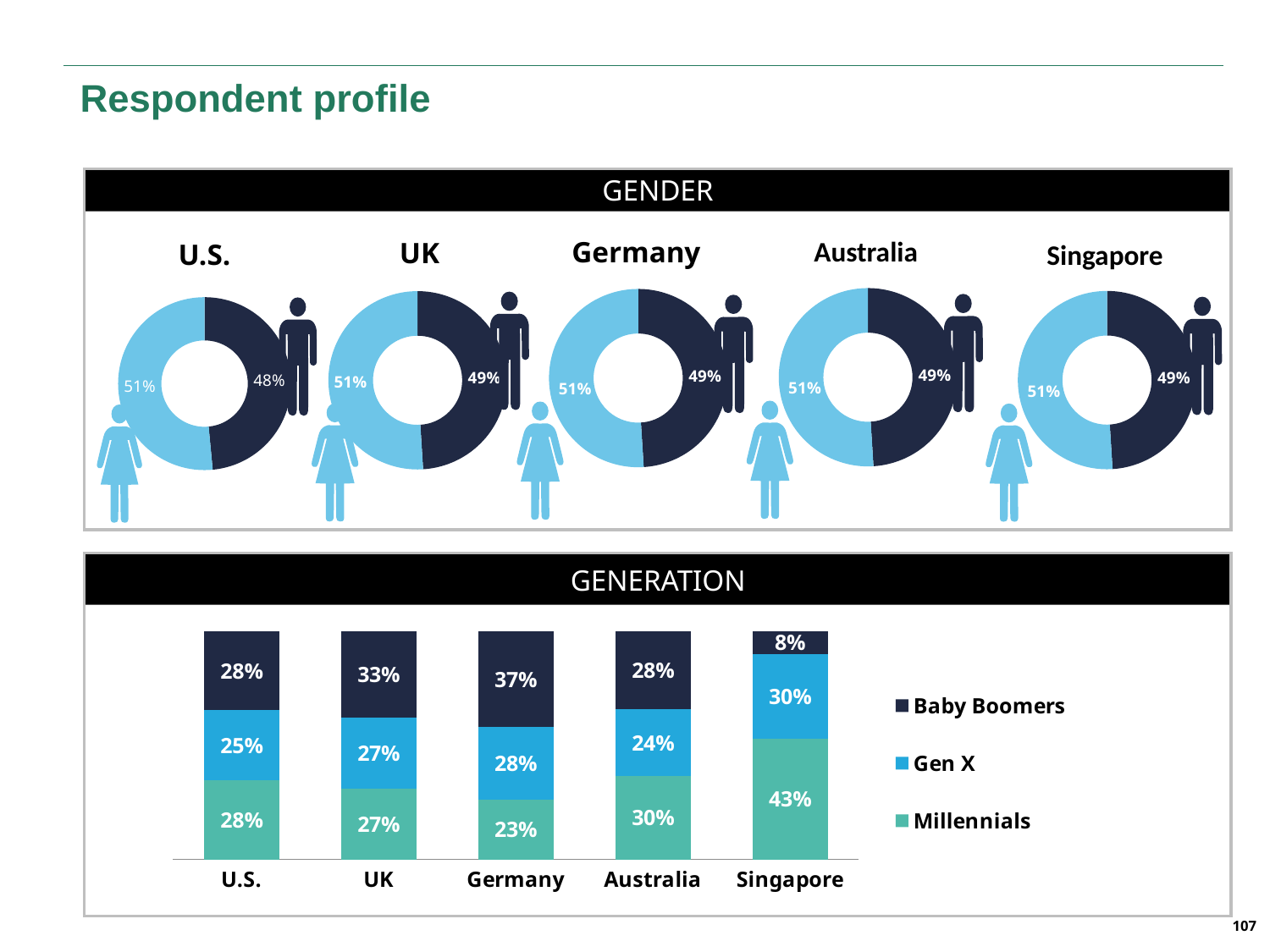
In the GENDER section, what value is shown on the dark segment of the U.S. donut chart? 48% How many series does the legend of the GENERATION chart list? 3 In the GENERATION chart, what percentage of Singapore respondents are Millennials? 43% In the GENERATION chart, which country has the highest Baby Boomers share? Germany In the GENERATION chart, what is the difference between the Millennials share for Singapore and for Germany? 20% What kind of chart is used in the GENERATION section? Stacked bar chart In the GENDER section, what value is shown on the light blue segment of the Singapore donut chart? 51% In the GENERATION chart, what percentage of Germany respondents are Baby Boomers? 37% In the GENERATION chart, is the Gen X share larger for the UK or for the U.S.? UK How many countries are shown on the x axis of the GENERATION chart? 5 In the GENERATION chart, which country has the lowest Baby Boomers share? Singapore In the GENERATION chart, what is the Gen X value for Australia? 24%